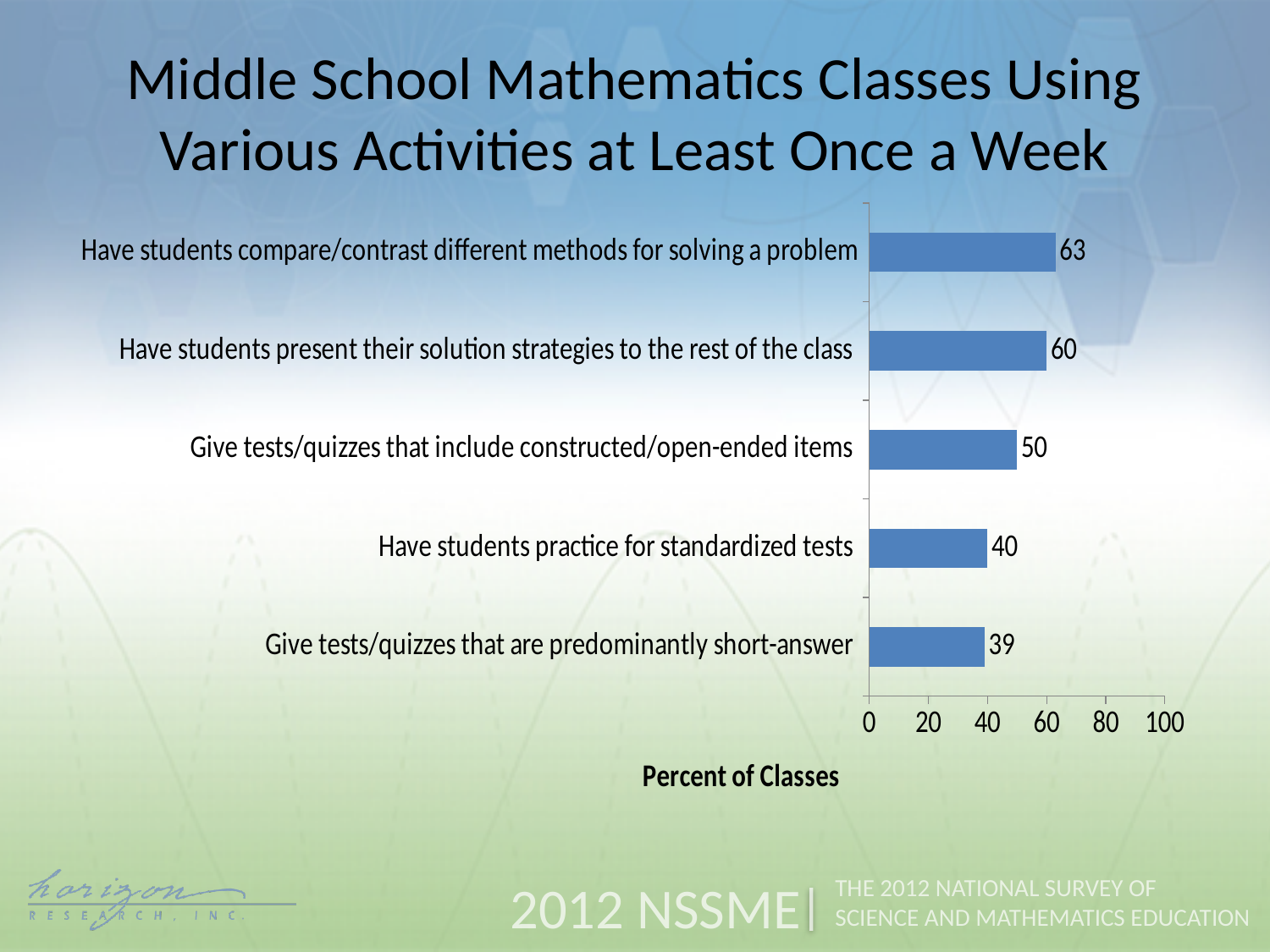
What is the maximum value shown on the horizontal axis? 100 What is the value for 'Have students practice for standardized tests'? 40 Which activity has the highest percent of classes? Have students compare/contrast different methods for solving a problem What kind of chart is shown on the slide? bar chart How many activities are shown in the chart? 5 What is the value for 'Give tests/quizzes that are predominantly short-answer'? 39 What is the difference between the value for 'Have students present their solution strategies to the rest of the class' and 'Give tests/quizzes that include constructed/open-ended items'? 10 Is the value for 'Have students compare/contrast different methods for solving a problem' greater or less than 60? greater What percent of classes have students compare/contrast different methods for solving a problem at least once a week? 63 What is the label of the horizontal axis? Percent of Classes Which is larger: the value for 'Have students practice for standardized tests' or 'Give tests/quizzes that include constructed/open-ended items'? Give tests/quizzes that include constructed/open-ended items Which activity has the lowest percent of classes? Give tests/quizzes that are predominantly short-answer